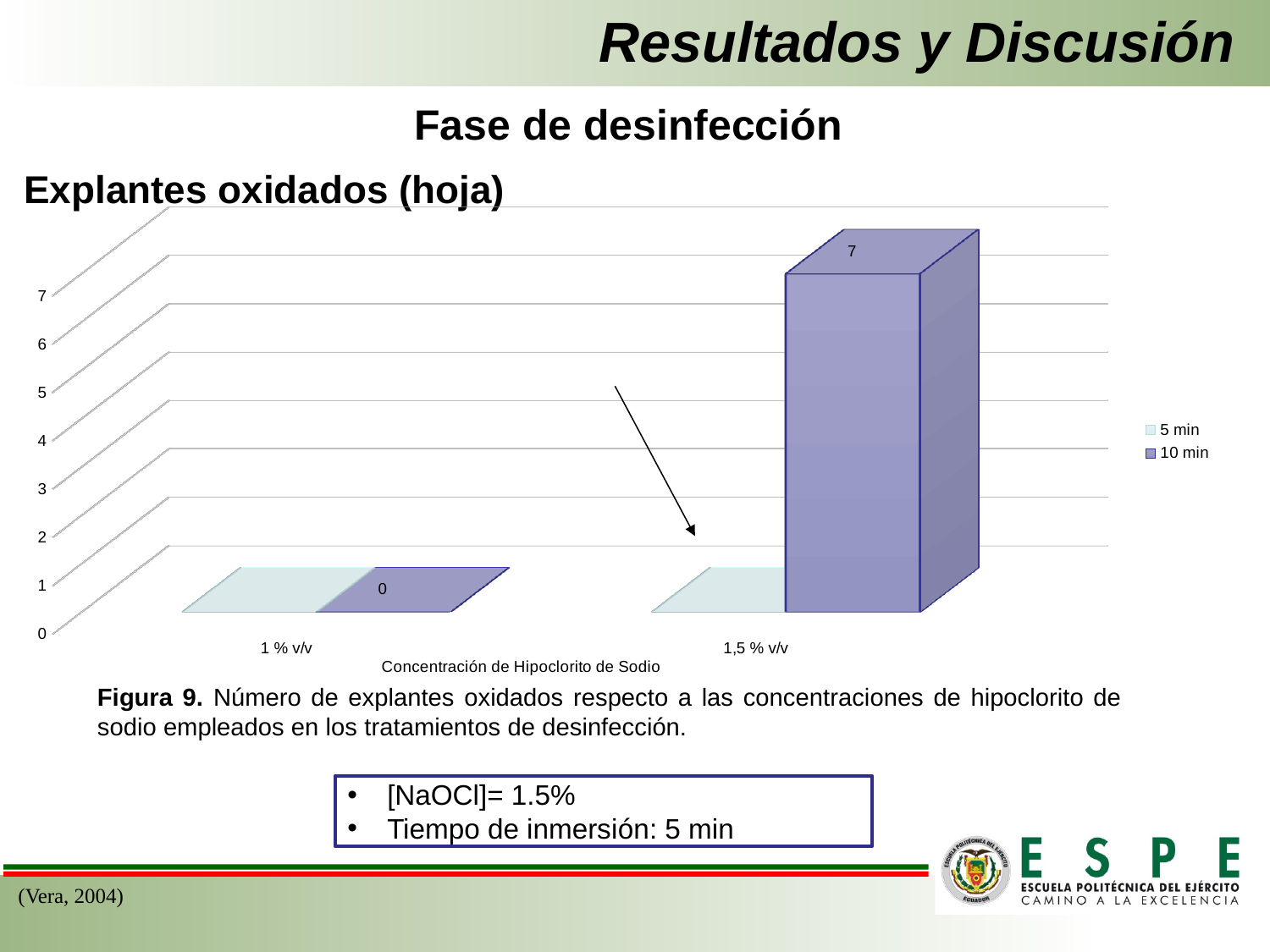
What is the value for the 10 min series at 1,5 % v/v? 7 How many series does the legend list? 2 What kind of chart is shown on the slide? bar chart Is the value for the 10 min series at 1,5 % v/v greater or less than 5? greater Which concentration has the highest value for the 10 min series? 1,5 % v/v For the 10 min series, which is larger: the value at 1 % v/v or at 1,5 % v/v? 1,5 % v/v What is the title of the x axis of the chart? Concentración de Hipoclorito de Sodio What is the value for the 10 min series at 1 % v/v? 0 How many concentration categories are shown on the x axis? 2 What is the difference between the 10 min values at 1,5 % v/v and 1 % v/v? 7 Does the 10 min series rise or fall from 1 % v/v to 1,5 % v/v? rises Which concentration has the lowest value for the 10 min series? 1 % v/v